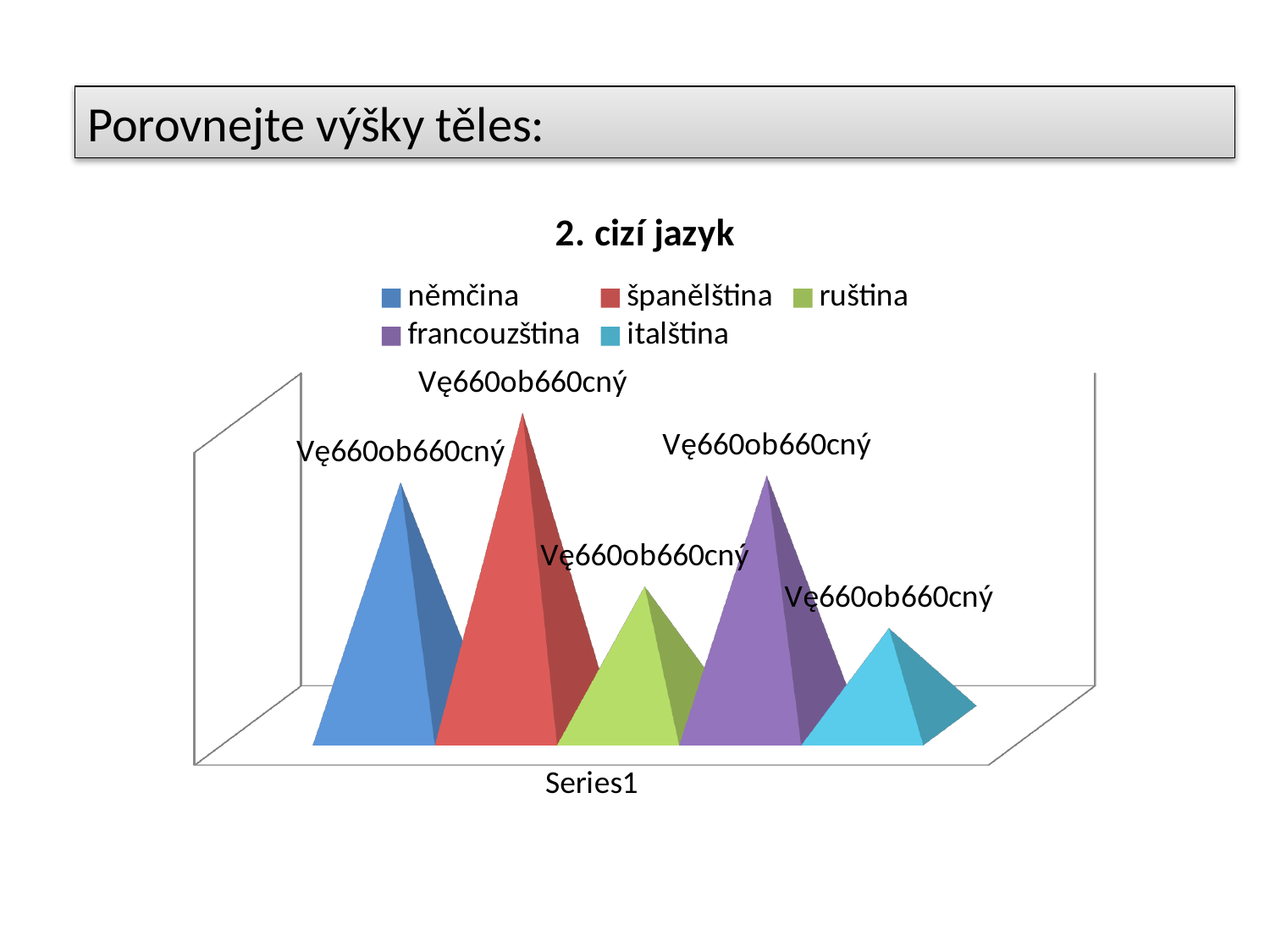
Which bar is taller, francouzština or ruština? francouzština Which language has the tallest bar in the chart? španělština What label is shown on the horizontal axis below the bars? Series1 Which bar is taller, španělština or francouzština? španělština Which bar is taller, španělština or němčina? španělština How many entries does the chart legend list? 5 How many pyramid-shaped bars are plotted in the chart? 5 Which language has the shortest bar in the chart? italština What kind of chart is shown on the slide? bar chart What is the title of the chart? 2. cizí jazyk Which legend entry is shown in red? španělština